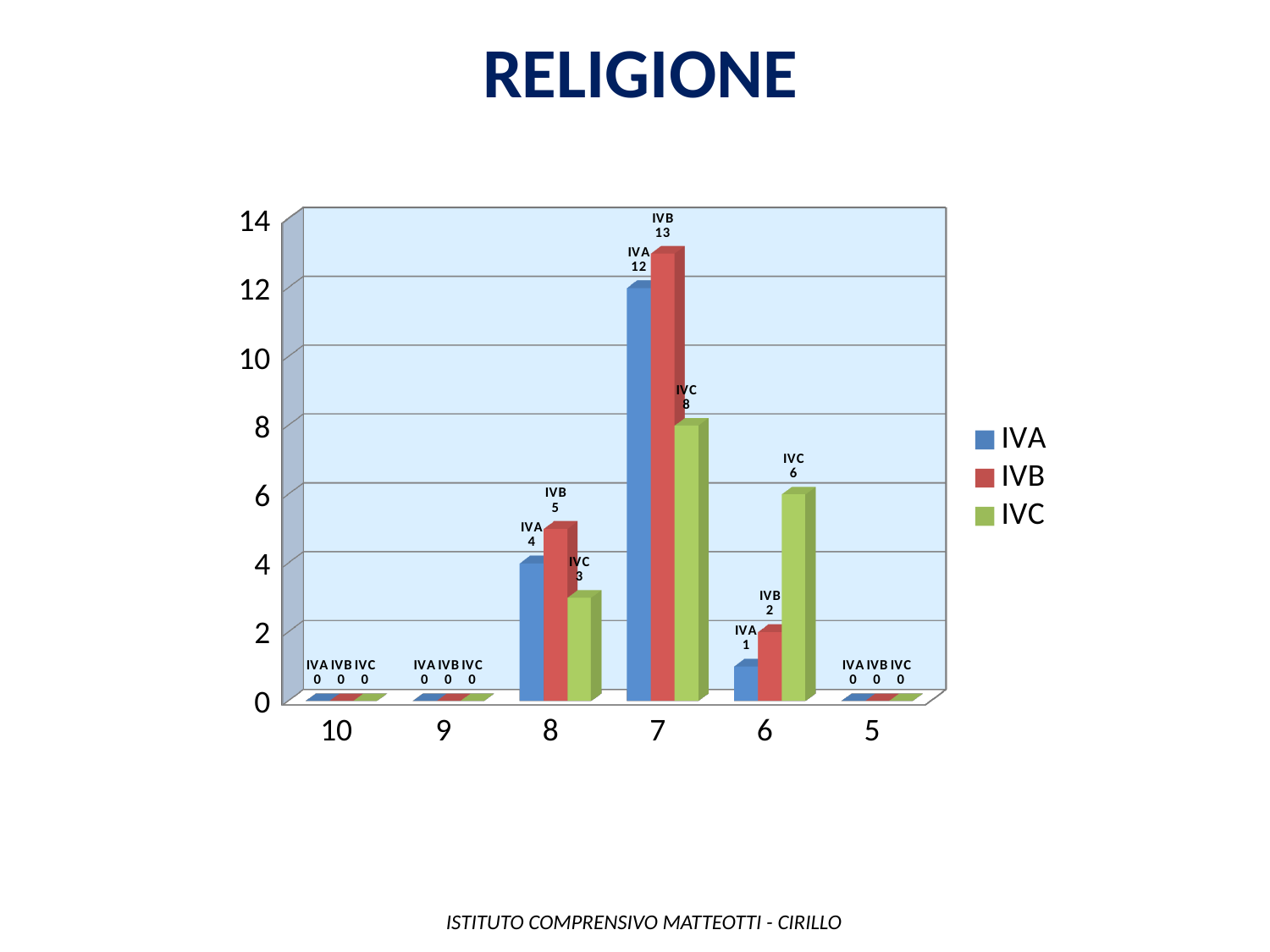
How many categories are shown on the x axis? 6 What kind of chart is shown on the slide? bar chart What is the value for IVB at category 7? 13 What is the title of the chart? RELIGIONE Which category has the highest value for IVA? 7 Which colour represents the IVC series? green What is the difference between IVB and IVC at category 7? 5 How many series does the legend list? 3 What is the total of IVA, IVB and IVC at category 8? 12 What is the value for IVC at category 6? 6 What is the value for IVA at category 8? 4 Which is larger at category 6, IVB or IVC? IVC